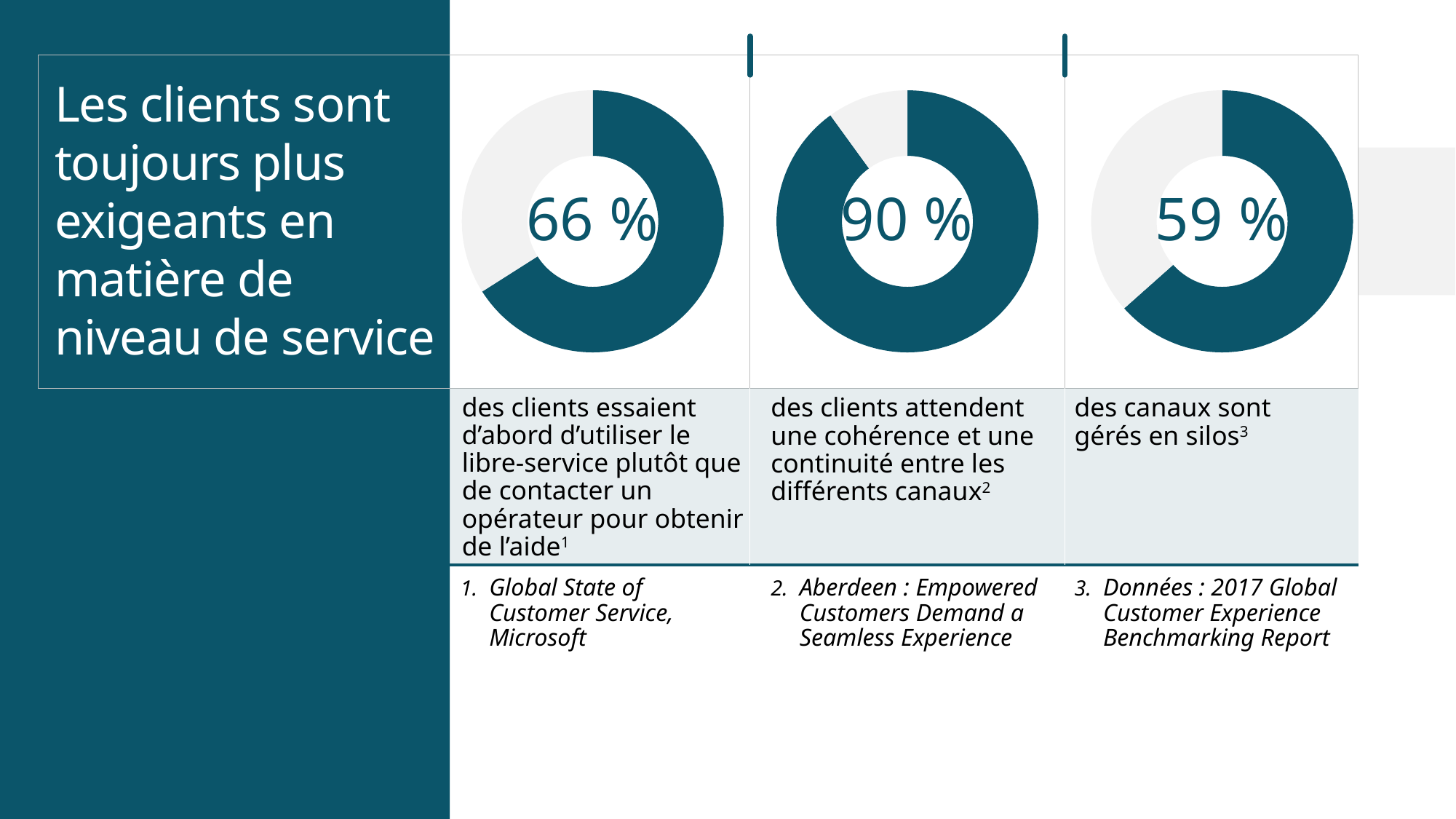
On the right-hand doughnut chart, what percentage is shown in the centre? 59 % Which of the three doughnut charts shows the highest percentage? The middle chart (90 %) What is the difference between the percentage on the middle doughnut chart and the percentage on the left-hand doughnut chart? 24 % What is the difference between the percentage on the left-hand doughnut chart and the percentage on the right-hand doughnut chart? 7 % Which of the three doughnut charts shows the lowest percentage? The right-hand chart (59 %) What kind of chart is used to display the three percentages on the slide? Doughnut (pie) chart How many doughnut charts are shown on the slide? 3 What colour is the filled portion of each doughnut chart? Dark teal blue On the left-hand doughnut chart, what percentage is shown in the centre? 66 % On the middle doughnut chart, what percentage is shown in the centre? 90 % Which is larger: the percentage on the left-hand doughnut chart or the percentage on the right-hand doughnut chart? The left-hand chart (66 %) Is the value shown on the middle doughnut chart greater or less than 50 %? greater